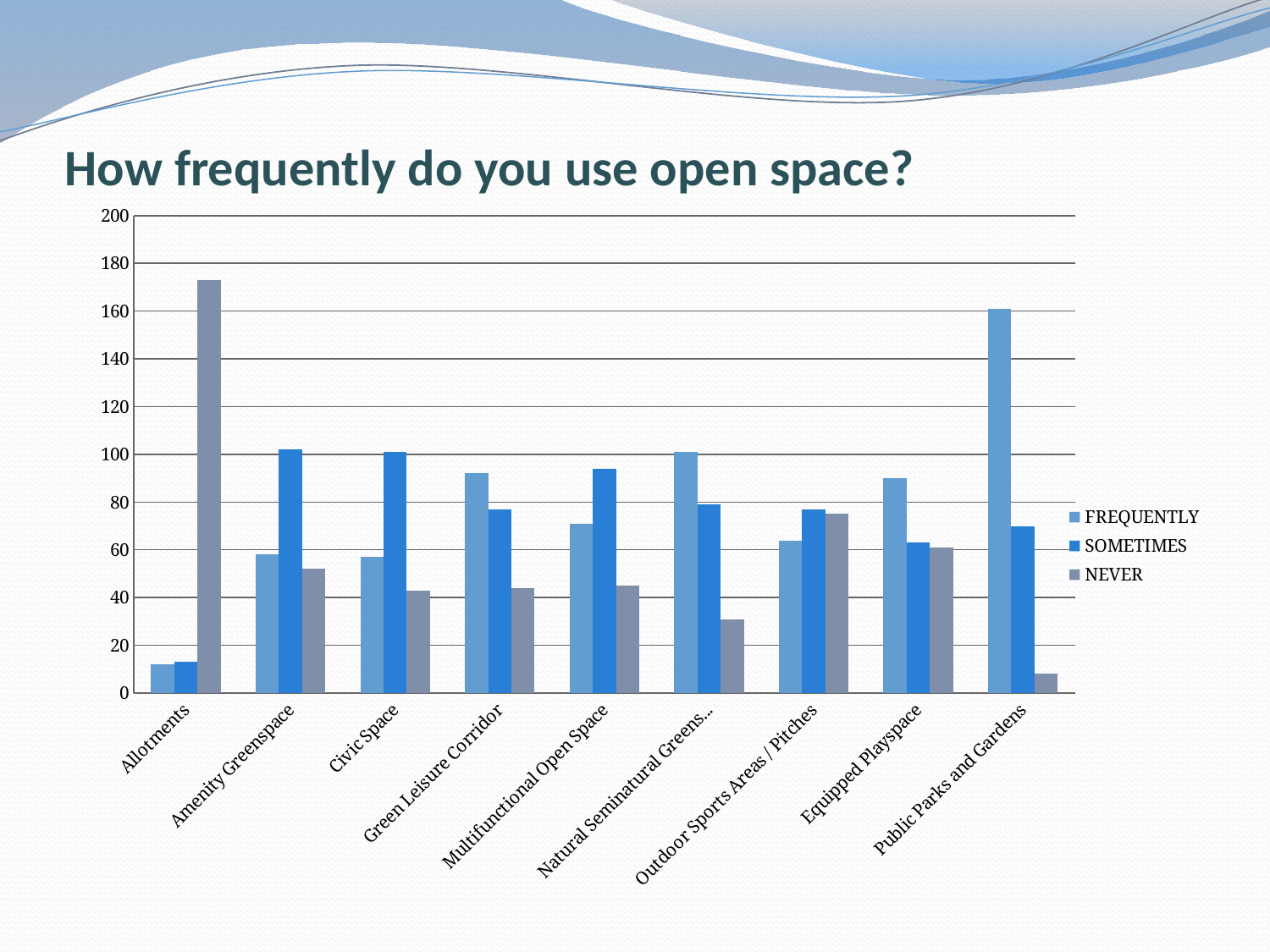
Which category has the lowest NEVER value? Public Parks and Gardens How many series does the legend list? 3 Is the SOMETIMES value for Allotments greater or less than 20? less Which category has the highest NEVER value? Allotments Is the FREQUENTLY value for Public Parks and Gardens greater or less than 140? greater How many open space categories are shown on the x axis? 9 Is the NEVER value for Allotments greater or less than 160? greater What kind of chart is shown on the slide? bar chart For Amenity Greenspace, which is larger: the FREQUENTLY value or the SOMETIMES value? SOMETIMES Which category has the highest FREQUENTLY value? Public Parks and Gardens For Green Leisure Corridor, which is larger: the FREQUENTLY value or the NEVER value? FREQUENTLY What is the title of the chart? How frequently do you use open space?